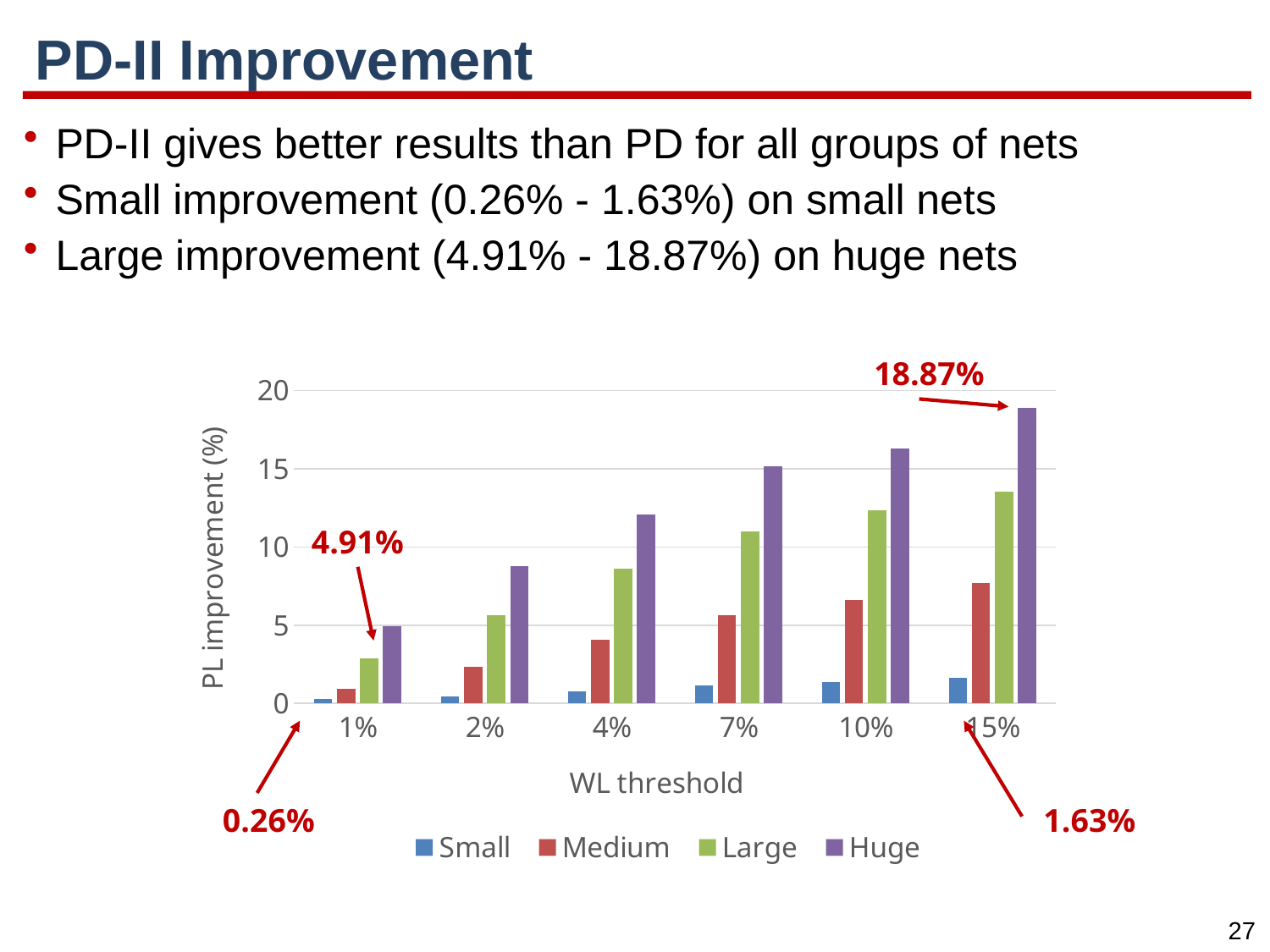
How many series does the legend list? 4 What is the difference between the Huge series values at the 15% and 1% WL thresholds? 13.96% What is the value for the Small series at the 1% WL threshold? 0.26% What is the difference between the Huge and Small series values at the 1% WL threshold? 4.65% What is the value for the Small series at the 15% WL threshold? 1.63% What is the value for the Huge series at the 15% WL threshold? 18.87% At the 10% WL threshold, which is larger: the Large series or the Medium series? Large What is the value for the Huge series at the 1% WL threshold? 4.91% Which series has the lowest bar at the 1% WL threshold? Small How many WL threshold categories are shown on the x axis? 6 Which series and WL threshold has the highest bar in the chart? Huge at 15% Is the value for the Huge series at the 10% WL threshold greater or less than 15? greater